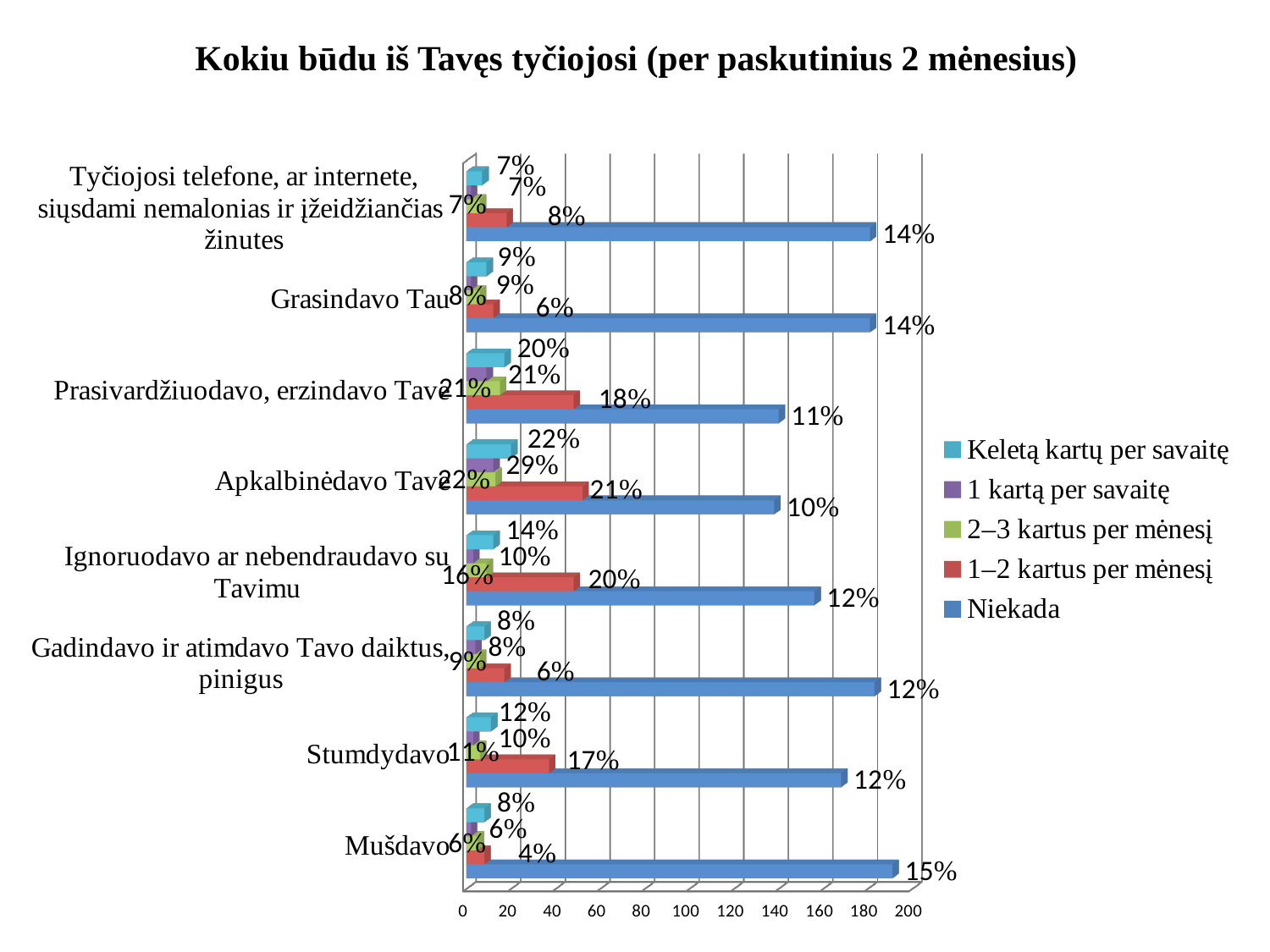
Is the 'Niekada' bar for 'Apkalbinėdavo Tave' greater or less than 160 on the horizontal axis? less How many categories are shown on the vertical axis? 8 How many series does the legend list? 5 What is the data label for 'Keletą kartų per savaitę' in the 'Prasivardžiuodavo, erzindavo Tave' category? 20% What kind of chart is shown on the slide? bar chart Which category has the highest 'Niekada' data label? Mušdavo What is the data label for '1 kartą per savaitę' in the 'Apkalbinėdavo Tave' category? 29% What is the data label for '1–2 kartus per mėnesį' in the 'Grasindavo Tau' category? 6% Which category has the lowest '1–2 kartus per mėnesį' data label? Mušdavo What is the data label for '1–2 kartus per mėnesį' in the 'Stumdydavo' category? 17% What is the data label for 'Niekada' in the 'Mušdavo' category? 15% What is the difference between the '1–2 kartus per mėnesį' labels for 'Ignoruodavo ar nebendraudavo su Tavimu' (20%) and 'Mušdavo' (4%)? 16 percentage points